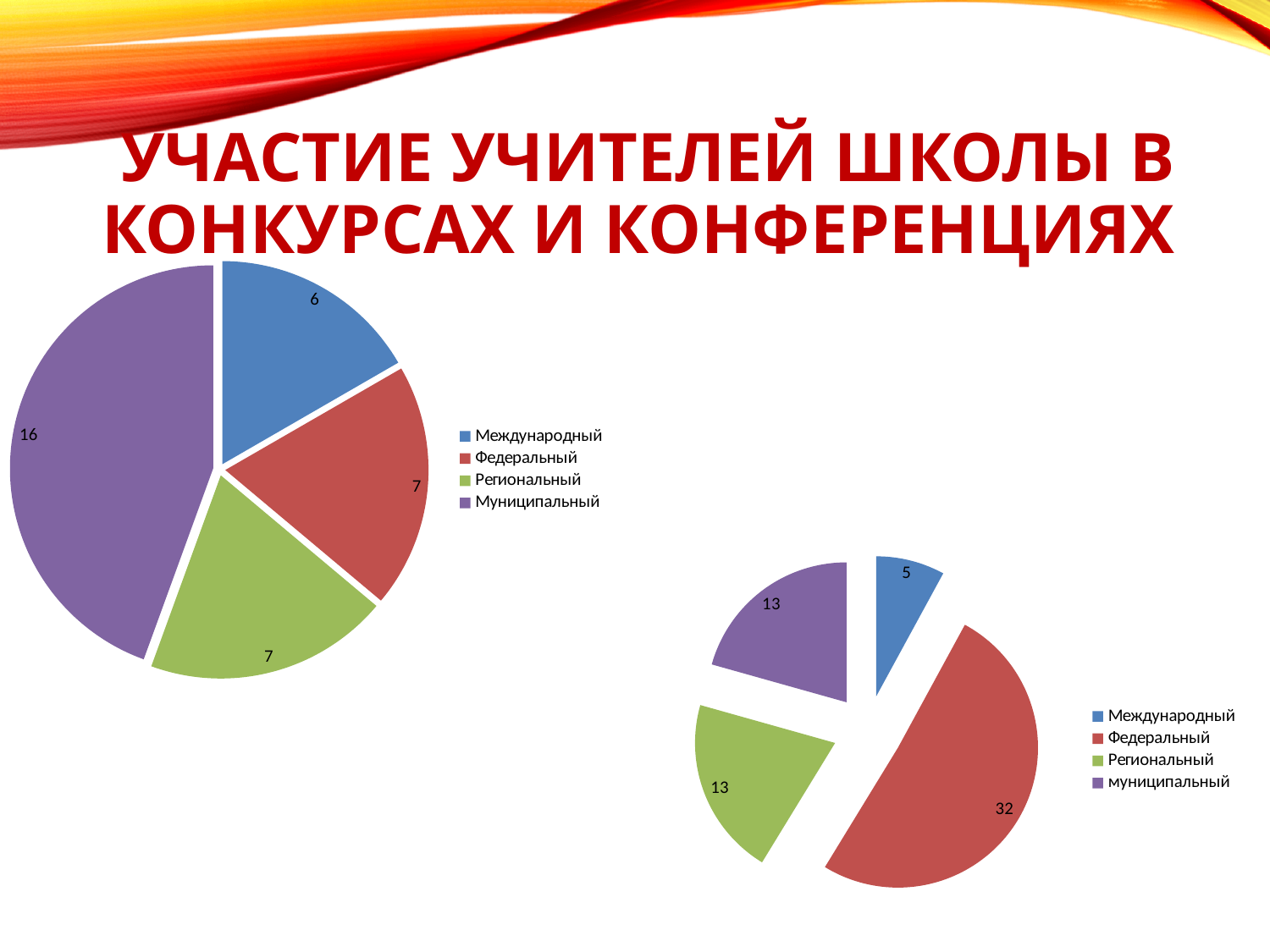
In the left pie chart, what colour is the Региональный slice? Green How many entries does the legend of the left pie chart list? 4 In the right pie chart, what is the value for Федеральный? 32 In the left pie chart, which is larger, the value for Муниципальный or the value for Федеральный? Муниципальный In the right pie chart, what is the difference between the values for Федеральный and Международный? 27 In the left pie chart, what is the value for Международный? 6 What type of chart is shown on the left of the slide? Pie chart In the right pie chart, what is the value for Региональный? 13 In the left pie chart, which category has the largest slice? Муниципальный How many slices does the right pie chart have? 4 In the left pie chart, what is the value for Муниципальный? 16 In the right pie chart, which category has the smallest slice? Международный